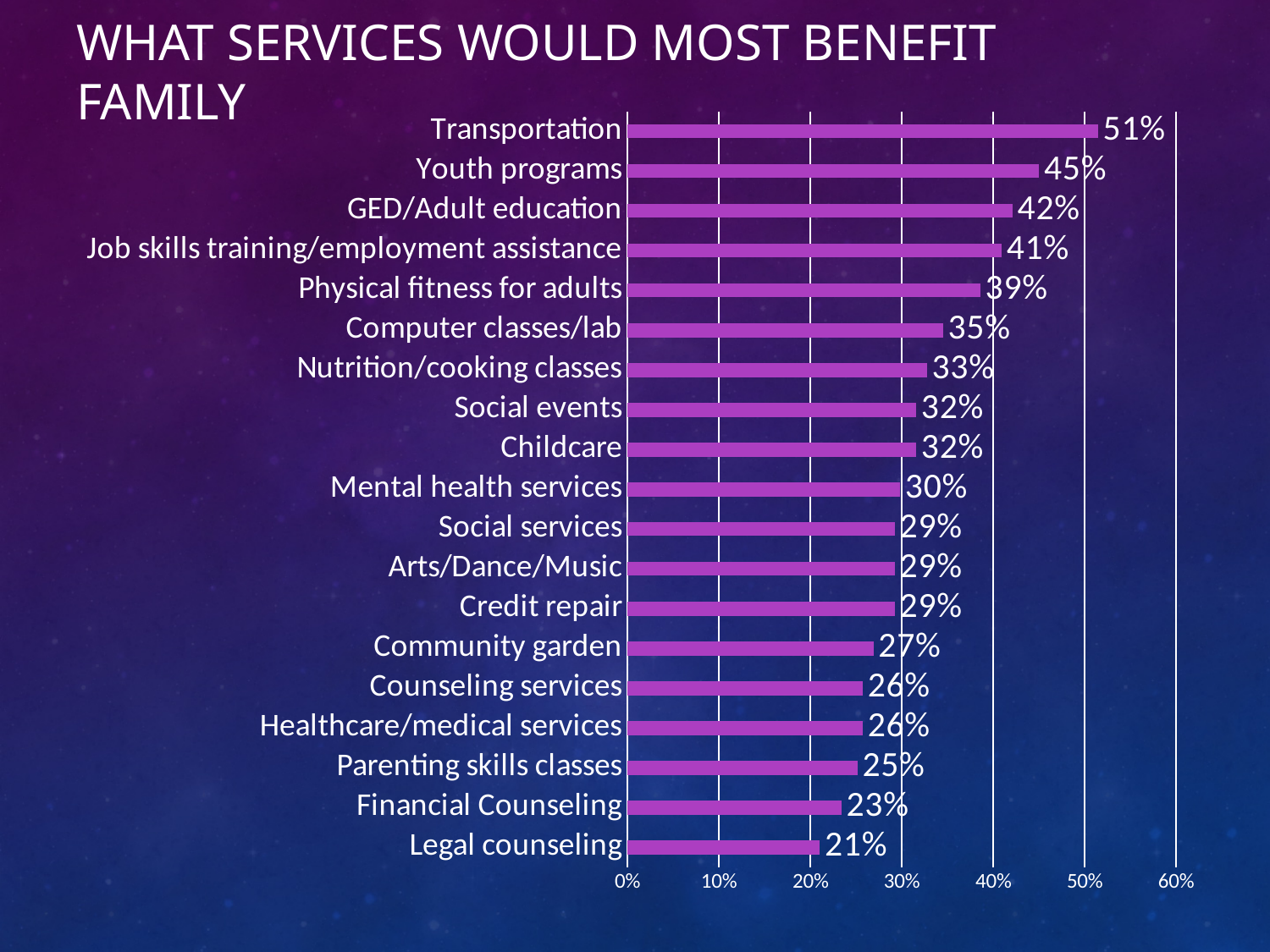
Which service has the highest percentage? Transportation How many services are listed in the chart? 19 What is the value for Computer classes/lab? 35% What is the difference between the values for Youth programs and GED/Adult education? 3% What percentage is shown for Transportation? 51% What kind of chart is shown on the slide? Bar chart Which service has the lowest percentage? Legal counseling What percentage is shown for Legal counseling? 21% What is the title of the slide? WHAT SERVICES WOULD MOST BENEFIT FAMILY Which is larger, the value for Physical fitness for adults or the value for Nutrition/cooking classes? Physical fitness for adults What is the difference between the values for Transportation and Legal counseling? 30% Is the value for Job skills training/employment assistance greater or less than 40%? greater